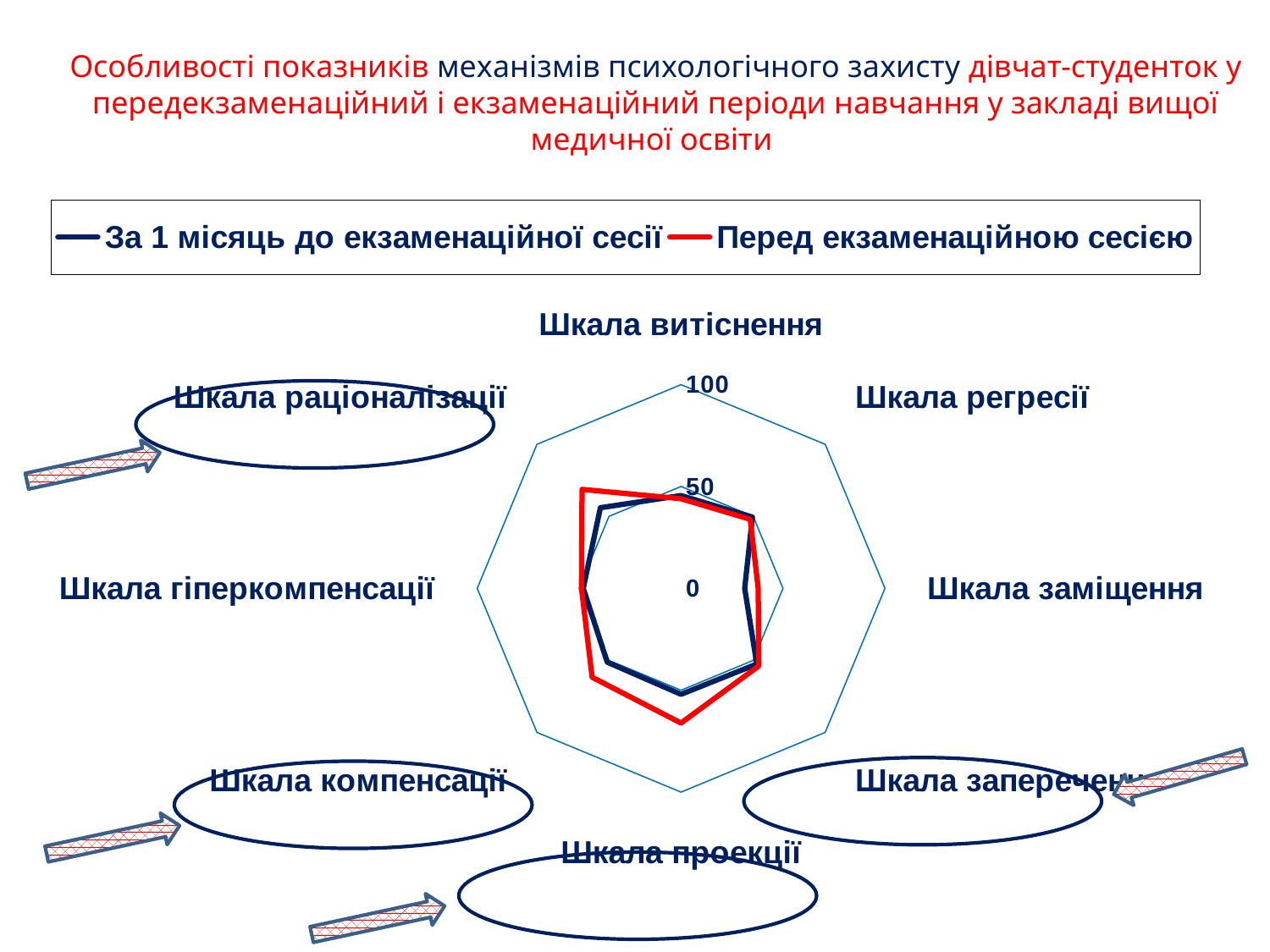
How many series does the legend list? 2 What is the highest value shown on the radar chart's axis? 100 Is the value for Шкала проекції in the series Перед екзаменаційною сесією greater or less than 50? greater Which series is drawn in red? Перед екзаменаційною сесією Which scale has the lowest value in the series За 1 місяць до екзаменаційної сесії? Шкала заміщення Is the value for Шкала раціоналізації in the series Перед екзаменаційною сесією greater or less than 50? greater For Шкала проекції, which series has the larger value: За 1 місяць до екзаменаційної сесії or Перед екзаменаційною сесією? Перед екзаменаційною сесією What kind of chart is shown on the slide? radar chart How many scales (categories) are plotted on the radar chart? 8 For Шкала раціоналізації, which series has the larger value: За 1 місяць до екзаменаційної сесії or Перед екзаменаційною сесією? Перед екзаменаційною сесією Is the value for Шкала компенсації in the series Перед екзаменаційною сесією greater or less than 50? greater